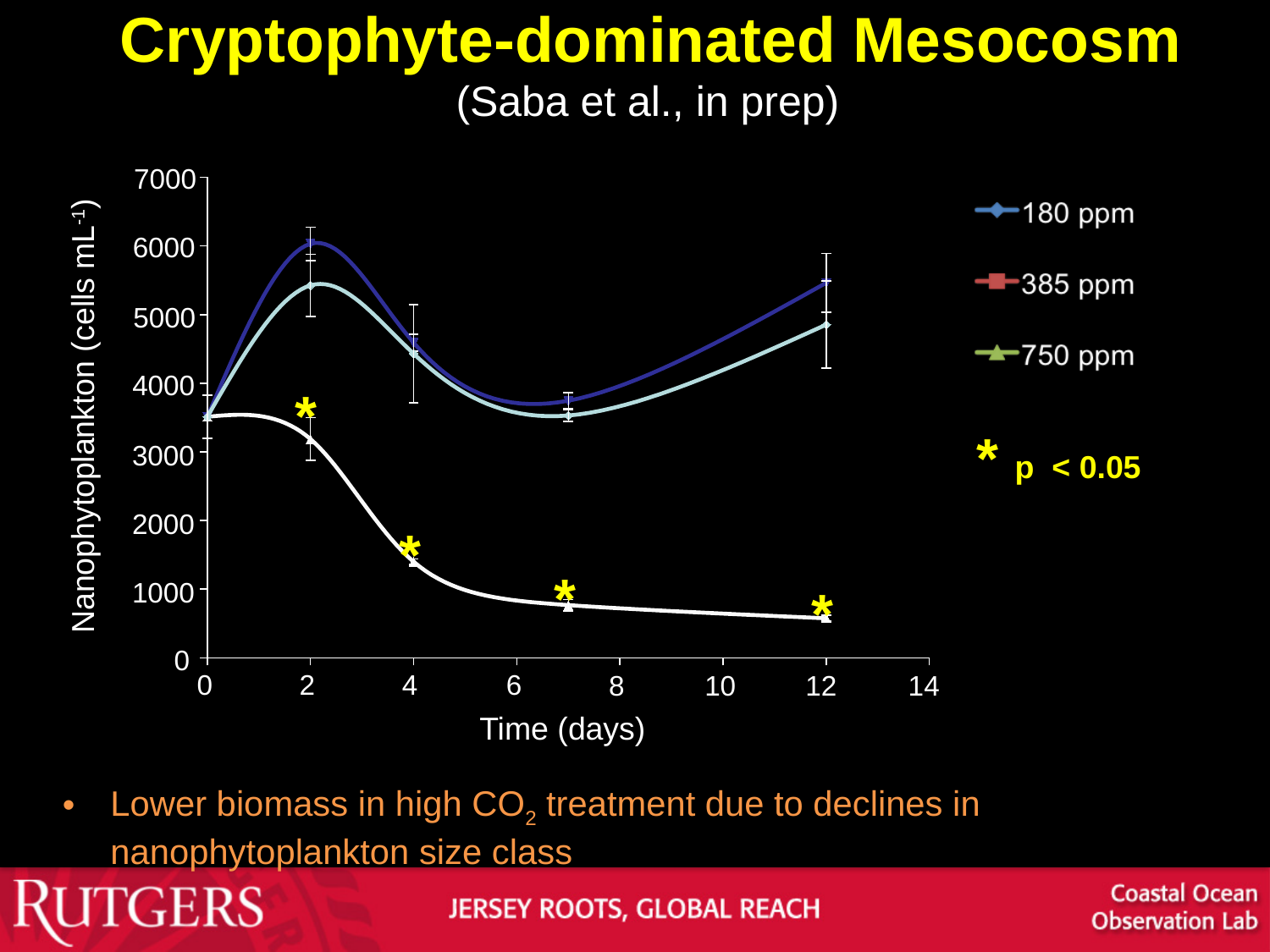
What kind of chart is shown on the slide? line chart What is the label of the x axis? Time (days) Is the value for 750 ppm at day 7 greater or less than 1000? less What is the highest tick value shown on the y axis? 7000 How many time points are plotted for each series? 5 How many series does the legend list? 3 Is the value for 750 ppm at day 12 greater or less than 1000? less Is the value for 750 ppm at day 4 greater or less than 2000? less Which series has the lowest value at day 12? 750 ppm Does the 750 ppm series rise or fall over time from day 0 to day 12? fall What are the three series named in the legend? 180 ppm, 385 ppm, 750 ppm